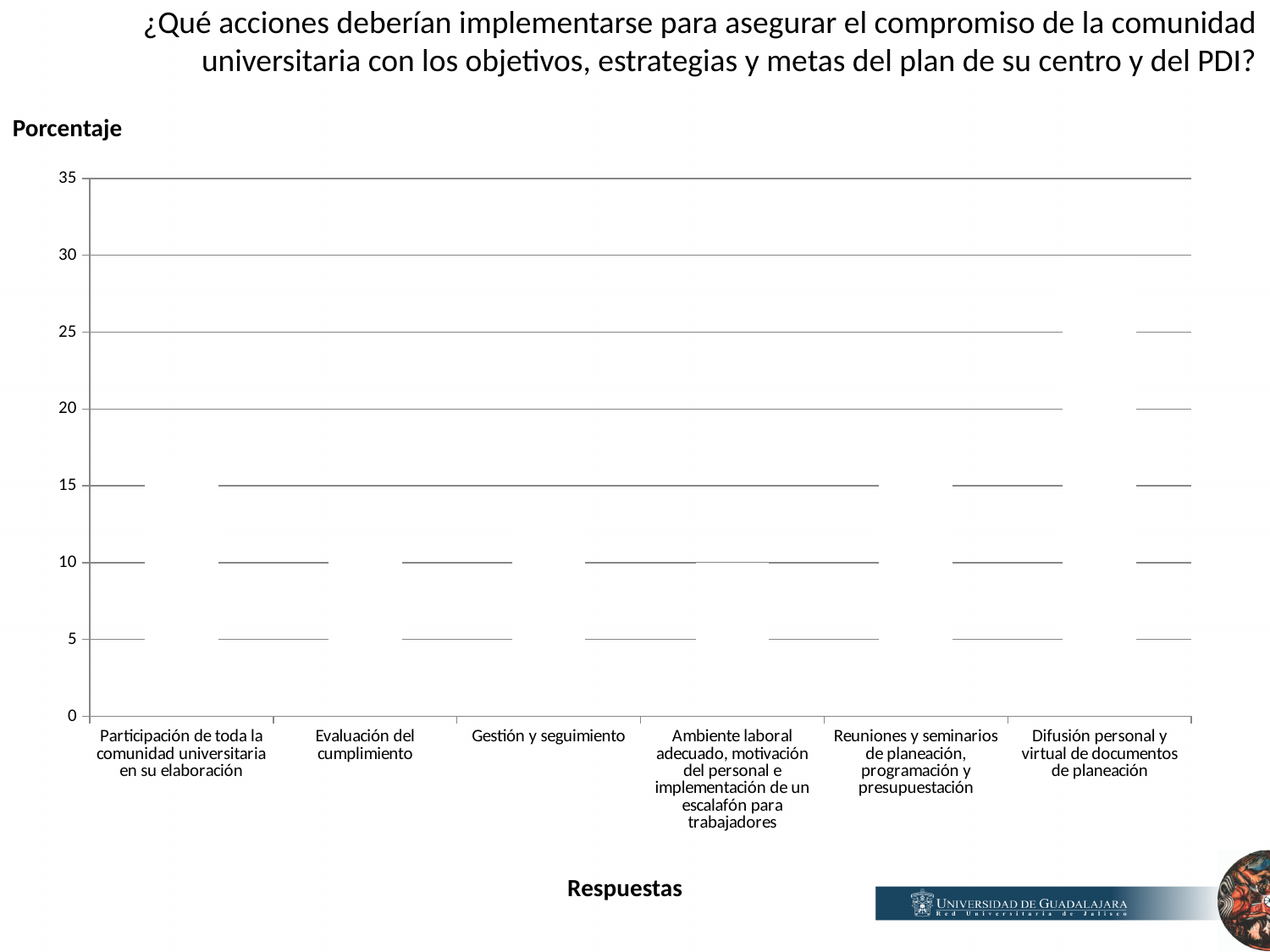
Is the value for Gestión y seguimiento greater or less than 15? less What is the highest value shown on the vertical axis of the chart? 35 What is the label of the horizontal axis of the chart? Respuestas How many response categories are shown on the x axis of the chart? 6 Is the value for Difusión personal y virtual de documentos de planeación greater or less than 20? greater What is the label of the vertical axis of the chart? Porcentaje Which category is the highest in the chart? Difusión personal y virtual de documentos de planeación